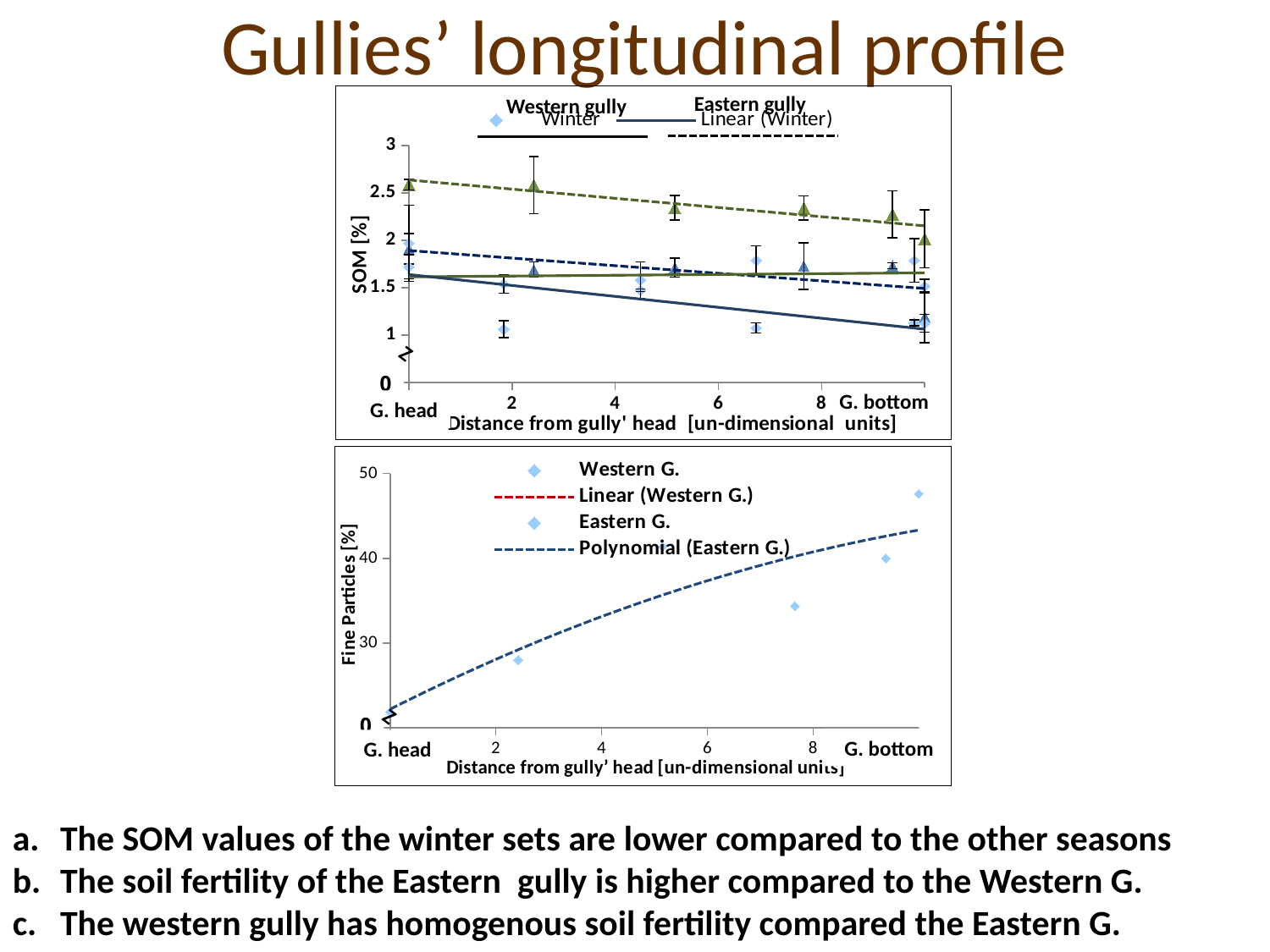
In the bottom chart, what is the label of the y axis? Fine Particles [%] In the bottom chart, is the Fine Particles value at distance 2.4 greater or less than 30? less In the bottom chart, how many entries does the legend list? 4 In the top chart, do the green triangle values rise or fall as distance from the gully head increases? fall In the top chart, is the green triangle value at distance 5.2 greater or less than 2.5? less What kind of chart is the top chart showing SOM [%]? scatter chart In the bottom chart, is the Fine Particles value at distance 7.6 greater or less than 40? less In the top chart, what is the label of the y axis? SOM [%] What kind of chart is the bottom chart showing Fine Particles [%]? scatter chart In the bottom chart, do the Fine Particles values rise or fall as distance from the gully head increases? rise